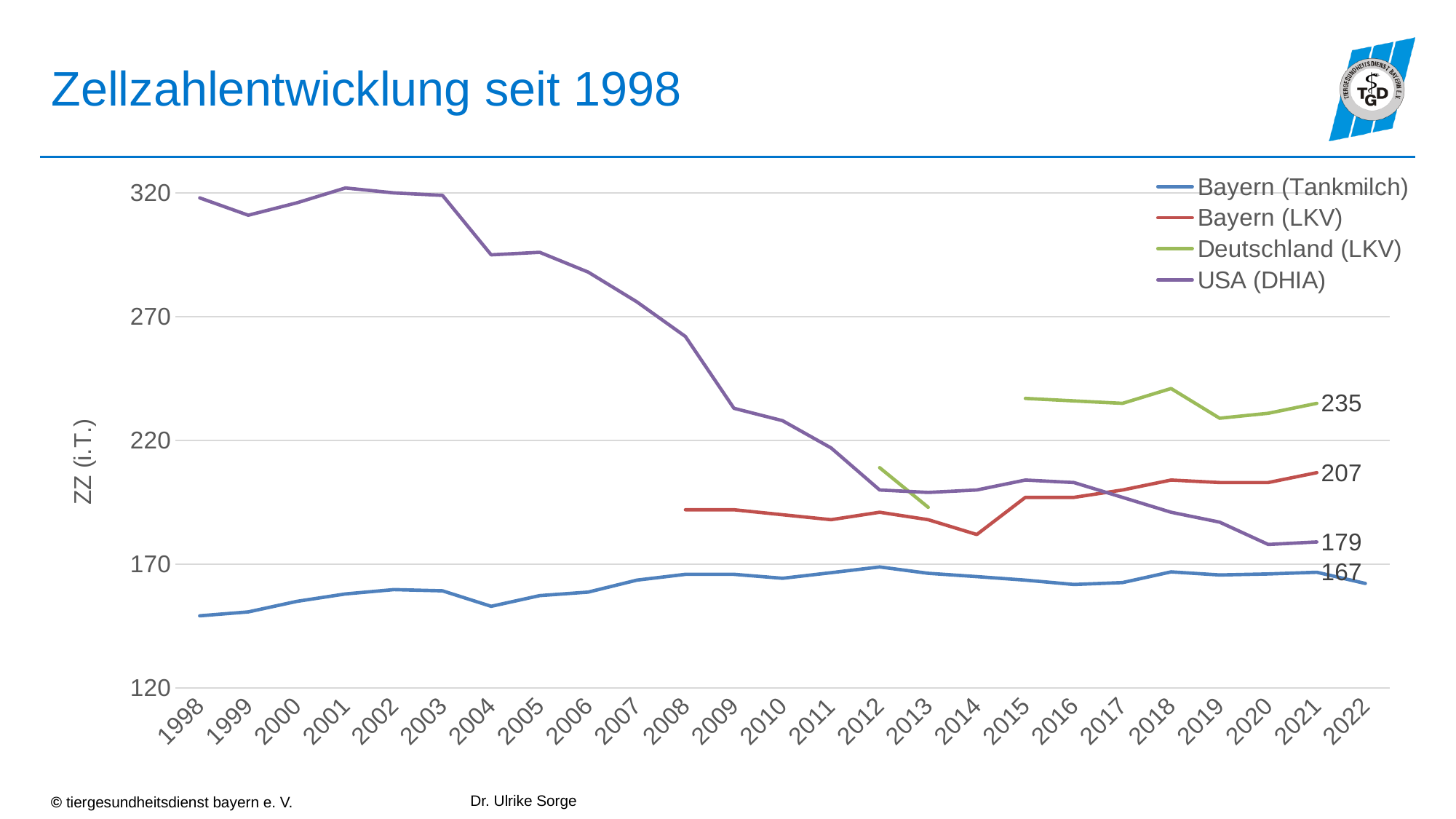
What value is labelled at the end of the Bayern (LKV) line? 207 How many series does the legend list? 4 What is the difference between the labelled values for Deutschland (LKV) and Bayern (LKV)? 28 How many years are shown on the x axis? 25 Is the value for USA (DHIA) in 1998 greater or less than 270? greater What value is labelled at the end of the Deutschland (LKV) line? 235 What is the difference between the labelled values for USA (DHIA) and Bayern (Tankmilch)? 12 What value is labelled on the Bayern (Tankmilch) line? 167 What value is labelled at the end of the USA (DHIA) line? 179 Which series has the highest labelled value at the end of the chart? Deutschland (LKV) Does the USA (DHIA) line rise or fall overall from 1998 to 2021? fall What kind of chart is shown on the slide? line chart